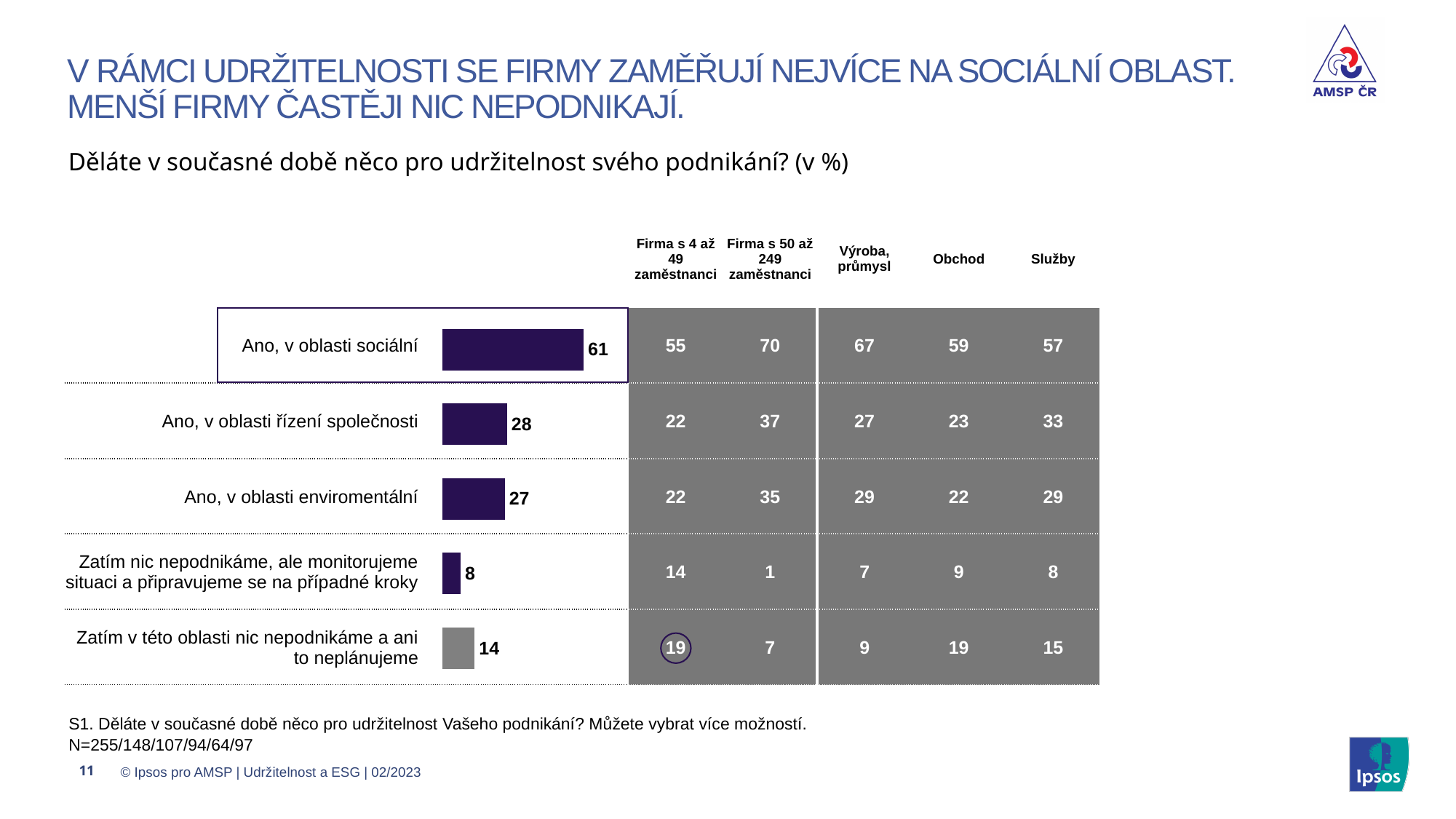
What is the value for "Ano, v oblasti sociální" in the bar chart? 61 Which category has the lowest value in the bar chart? Zatím nic nepodnikáme, ale monitorujeme situaci a připravujeme se na případné kroky What is the value for "Ano, v oblasti enviromentální"? 27 Which category has the highest value in the bar chart? Ano, v oblasti sociální Which bar in the chart is coloured grey rather than dark purple? Zatím v této oblasti nic nepodnikáme a ani to neplánujeme What is the value for "Ano, v oblasti řízení společnosti"? 28 Which is larger: the value for "Zatím v této oblasti nic nepodnikáme a ani to neplánujeme" or for "Zatím nic nepodnikáme, ale monitorujeme situaci a připravujeme se na případné kroky"? Zatím v této oblasti nic nepodnikáme a ani to neplánujeme What is the difference between the values for "Ano, v oblasti řízení společnosti" and "Ano, v oblasti enviromentální"? 1 How many categories are shown in the bar chart? 5 What is the difference between the values for "Ano, v oblasti sociální" and "Ano, v oblasti řízení společnosti"? 33 What is the value for "Zatím v této oblasti nic nepodnikáme a ani to neplánujeme"? 14 What kind of chart is shown on the slide? Bar chart